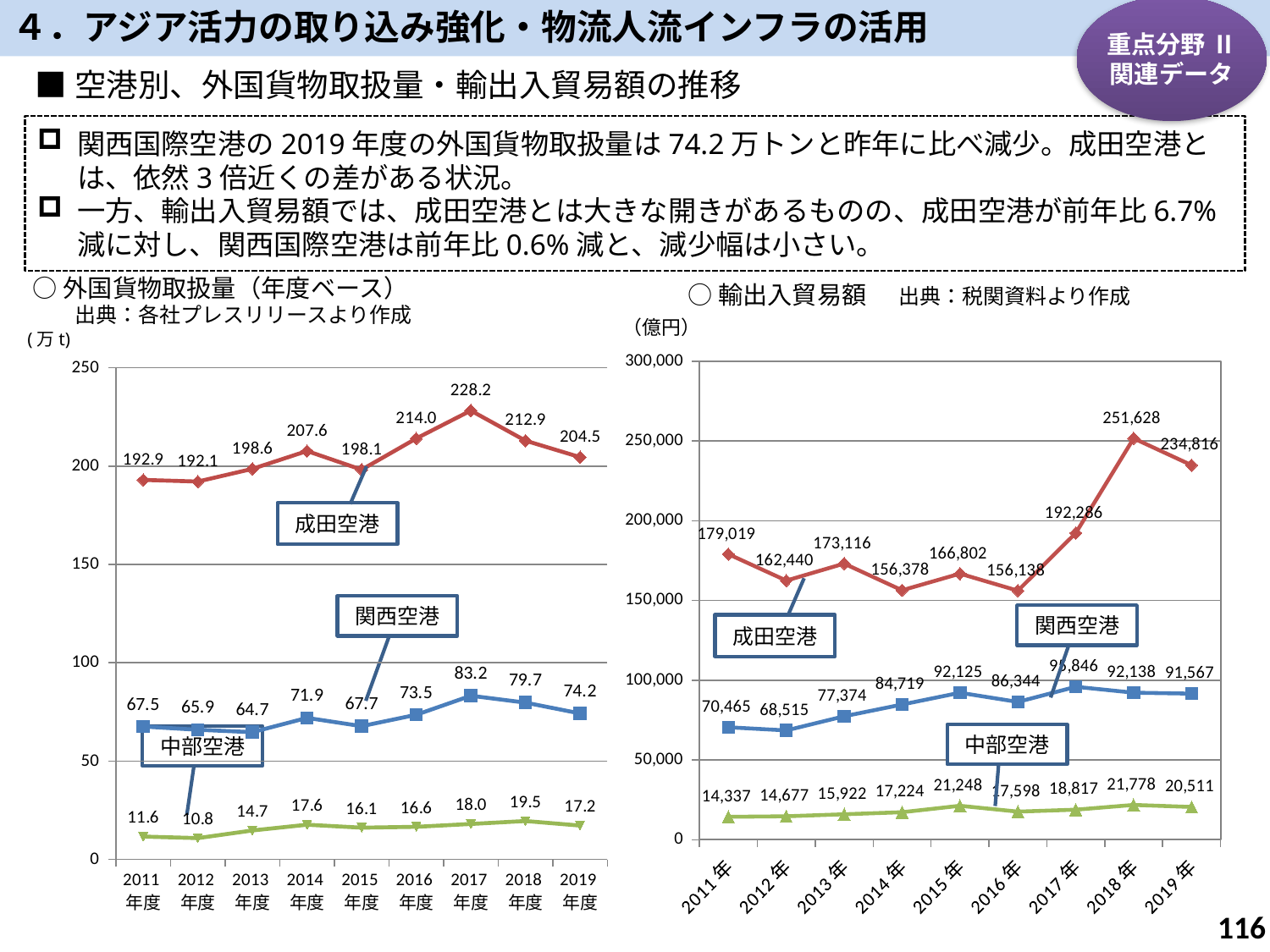
In the right chart (輸出入貿易額), which is larger: 成田空港 in 2016年 or 成田空港 in 2017年? 成田空港 in 2017年 In the right chart (輸出入貿易額), how many series (airports) are plotted? 3 In the right chart (輸出入貿易額), what is the difference between 関西空港 in 2018年 and 2019年? 571 In the left chart (外国貨物取扱量), what is the difference between 成田空港 and 関西空港 in 2019年度? 130.3 In the left chart (外国貨物取扱量), what is the value for 関西空港 in 2019年度? 74.2 In the left chart (外国貨物取扱量), what is the value for 成田空港 in 2017年度? 228.2 In the left chart (外国貨物取扱量), how many years are shown on the x axis? 9 In the right chart (輸出入貿易額), in which year is the value for 関西空港 the highest? 2017年 In the right chart (輸出入貿易額), what is the value for 成田空港 in 2018年? 251,628 In the left chart (外国貨物取扱量), in which year is the value for 中部空港 the lowest? 2012年度 In the right chart (輸出入貿易額), what is the value for 中部空港 in 2015年? 21,248 What type of chart is the left chart (外国貨物取扱量)? line chart